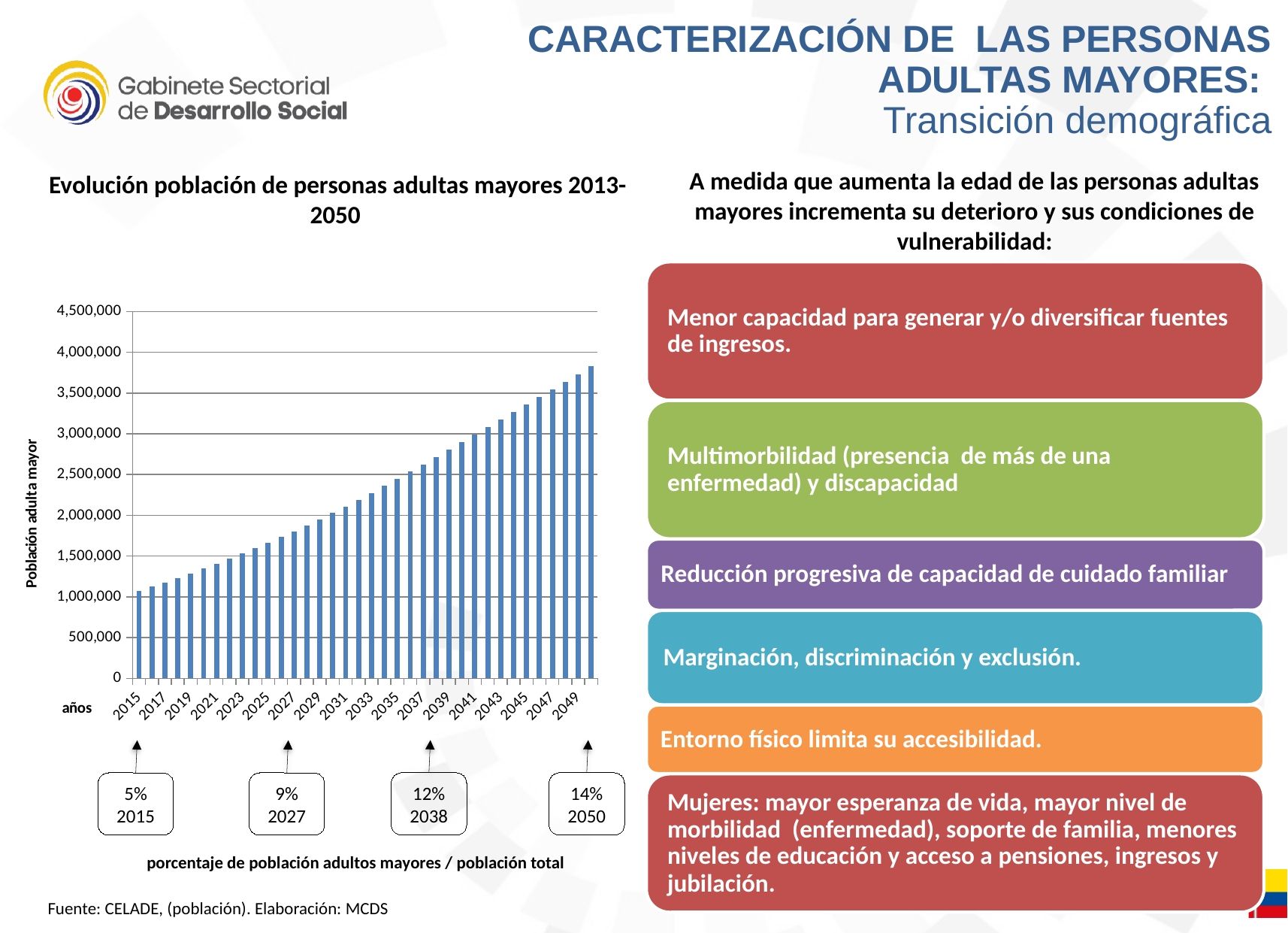
Which year has the shortest bar in the chart? 2015 What kind of chart is shown on the slide? bar chart Which year has the tallest bar in the chart? 2050 Is the value for 2015 greater or less than 1,500,000? less What is the title of the chart? Evolución población de personas adultas mayores 2013-2050 Is the value for 2027 greater or less than 1,500,000? greater Is the value for 2038 greater or less than 2,500,000? greater Do the bar values rise or fall from 2015 to 2049 along the x axis? rise According to the callout below the chart, what percentage of the total population do older adults represent in 2027? 9% What is the label on the vertical axis of the chart? Población adulta mayor Which year has the larger bar, 2025 or 2035? 2035